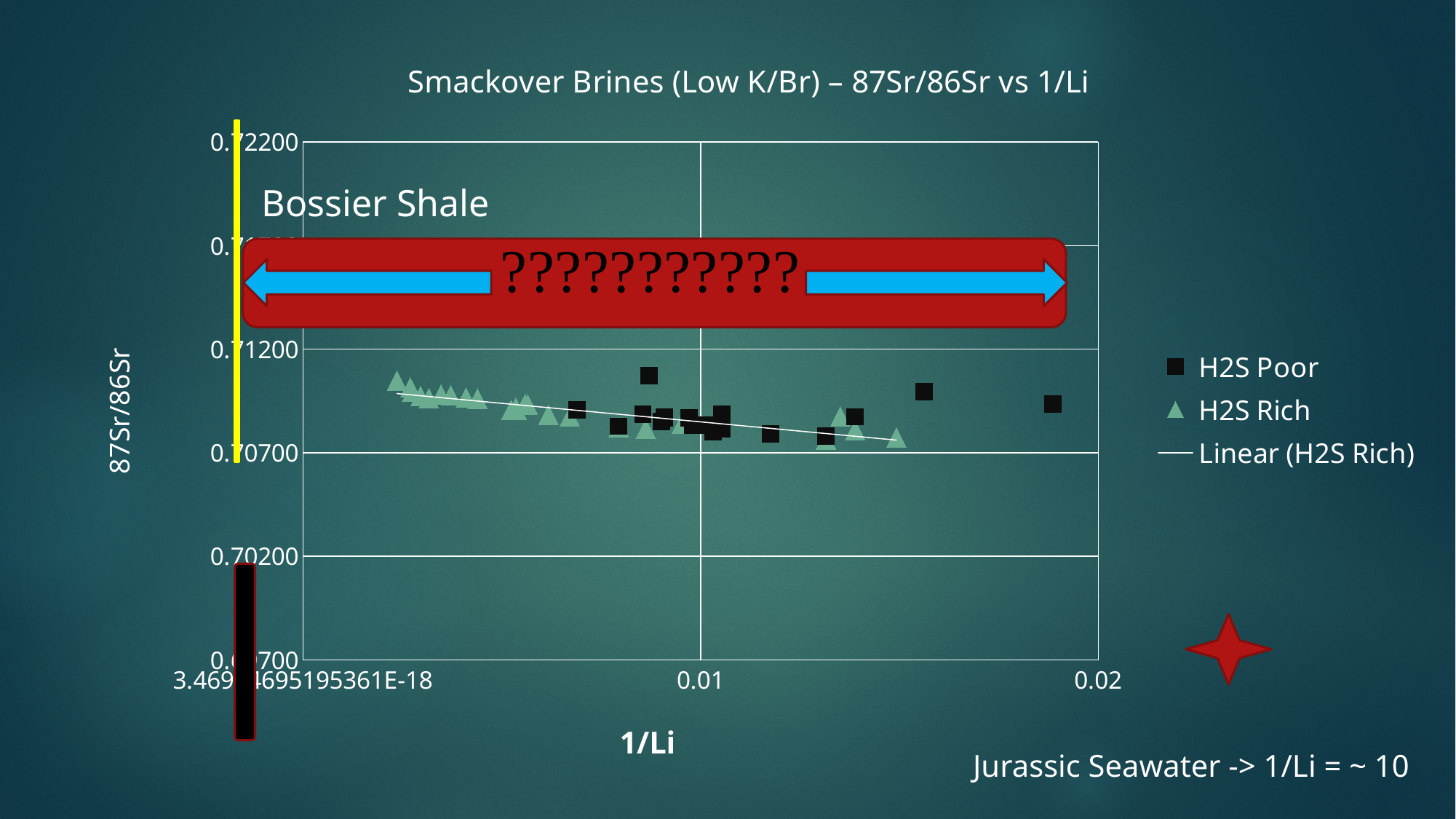
Is the highest H2S Poor point greater or less than 0.71200 on the 87Sr/86Sr axis? less Does the Linear (H2S Rich) trendline rise or fall as 1/Li increases? Fall Which legend entry is shown with black square markers? H2S Poor What kind of chart is shown on the slide? Scatter chart What is the title of the chart? Smackover Brines (Low K/Br) – 87Sr/86Sr vs 1/Li Which series has the point with the smallest 1/Li value, H2S Poor or H2S Rich? H2S Rich Are the H2S Rich points at 1/Li below 0.01 greater or less than 0.70700 on the 87Sr/86Sr axis? greater What is the label of the x axis? 1/Li Is the rightmost H2S Poor point at a 1/Li value greater or less than 0.01? greater Which series has the point with the largest 1/Li value, H2S Poor or H2S Rich? H2S Poor How many entries does the chart legend list? 3